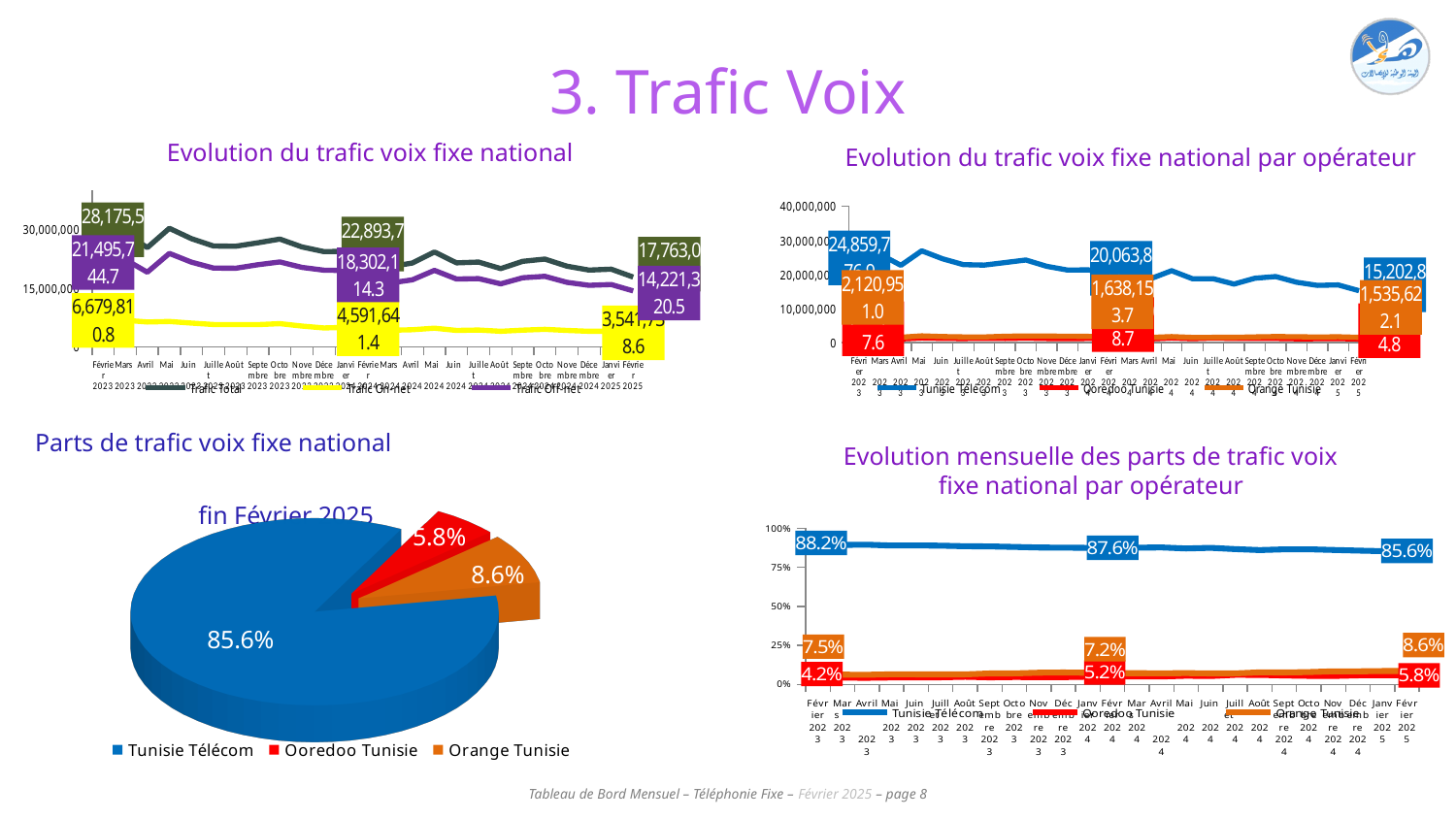
In the chart 'Evolution du trafic voix fixe national par opérateur', which operator has the highest traffic throughout the period? Tunisie Télécom In the pie chart 'Parts de trafic voix fixe national fin Février 2025', what share does Tunisie Télécom hold? 85.6% In the pie chart 'Parts de trafic voix fixe national fin Février 2025', which operator has the smallest slice? Ooredoo Tunisie In the pie chart 'Parts de trafic voix fixe national fin Février 2025', what is the difference between the Tunisie Télécom share and the Orange Tunisie share? 77.0% In the chart 'Evolution mensuelle des parts de trafic voix fixe national par opérateur', does the Tunisie Télécom share rise or fall from Février 2023 to Février 2025? fall In the chart 'Evolution mensuelle des parts de trafic voix fixe national par opérateur', is the Tunisie Télécom share at Février 2025 greater or less than 75%? greater In the pie chart 'Parts de trafic voix fixe national fin Février 2025', what share does Ooredoo Tunisie hold? 5.8% How many operators does the legend of the pie chart 'Parts de trafic voix fixe national fin Février 2025' list? 3 In the pie chart 'Parts de trafic voix fixe national fin Février 2025', what share does Orange Tunisie hold? 8.6% What kind of chart is 'Evolution du trafic voix fixe national par opérateur'? line chart In the chart 'Evolution mensuelle des parts de trafic voix fixe national par opérateur', what is the Tunisie Télécom share labelled at Février 2023? 88.2%